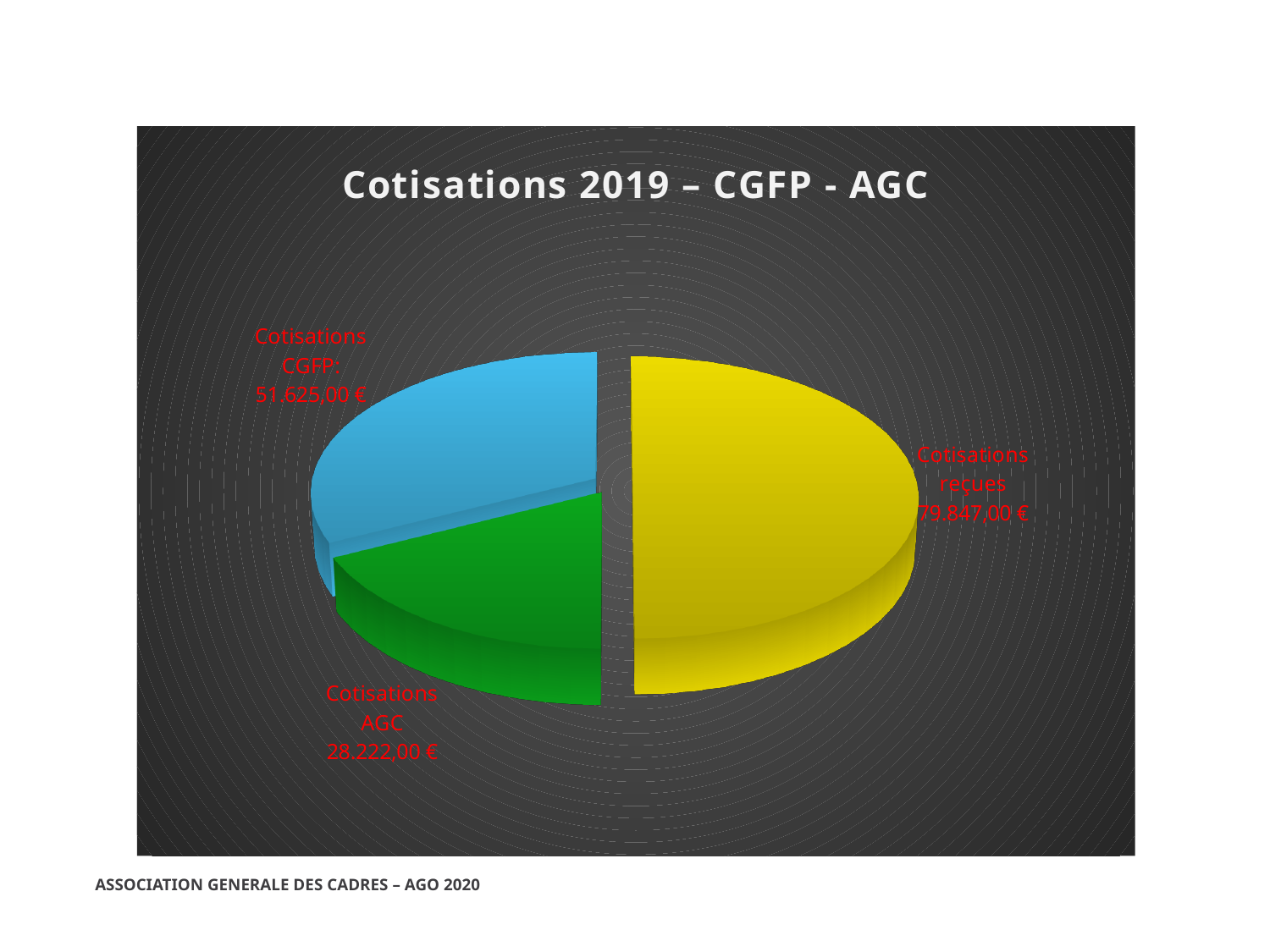
Which is larger, Cotisations CGFP or Cotisations AGC? Cotisations CGFP What is the difference between Cotisations CGFP and Cotisations AGC? 23.403,00 € What colour is the Cotisations reçues slice? Yellow How many slices does the pie chart have? 3 What type of chart is shown on the slide? Pie chart What is the value of the Cotisations CGFP slice? 51.625,00 € Which slice has the largest value? Cotisations reçues What is the difference between Cotisations reçues and Cotisations CGFP? 28.222,00 € What is the value of the Cotisations reçues slice? 79.847,00 € Which slice has the smallest value? Cotisations AGC What is the title of the chart? Cotisations 2019 – CGFP - AGC What is the value of the Cotisations AGC slice? 28.222,00 €